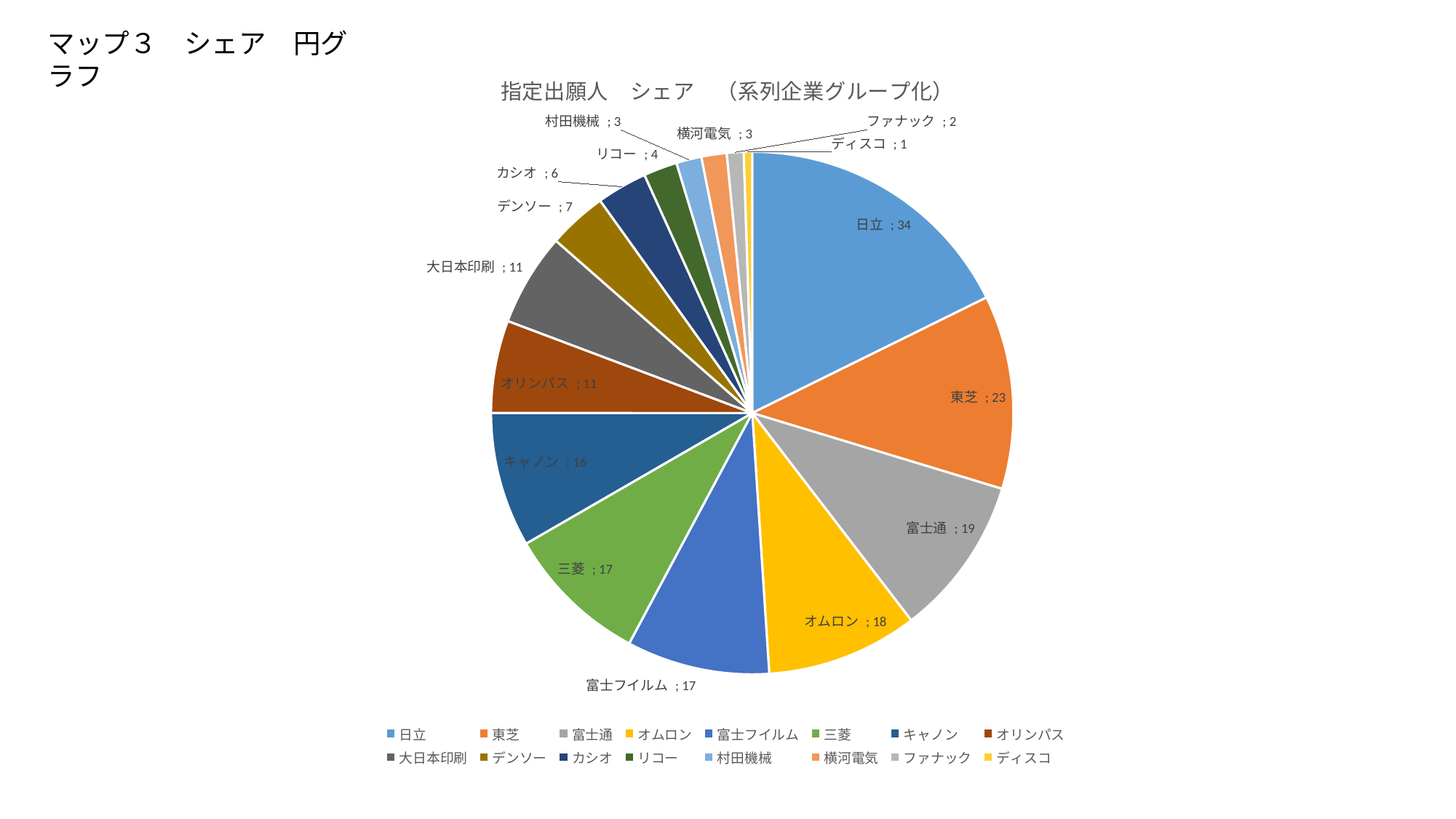
What kind of chart is shown on the slide? Pie chart What is the difference between the values for 富士通 and キヤノン? 3 What is the title of the chart? 指定出願人 シェア （系列企業グループ化） What is the value shown for 大日本印刷 in the pie chart? 11 What is the value shown for オムロン in the pie chart? 18 Which is larger, the value for 東芝 or the value for 富士通? 東芝 What is the total of all the values in the pie chart? 192 What is the difference between the values for 日立 and 東芝? 11 Which category has the largest slice in the pie chart? 日立 What is the value shown for 日立 in the pie chart? 34 How many categories (slices) does the pie chart have? 16 Which category has the smallest slice in the pie chart? ディスコ